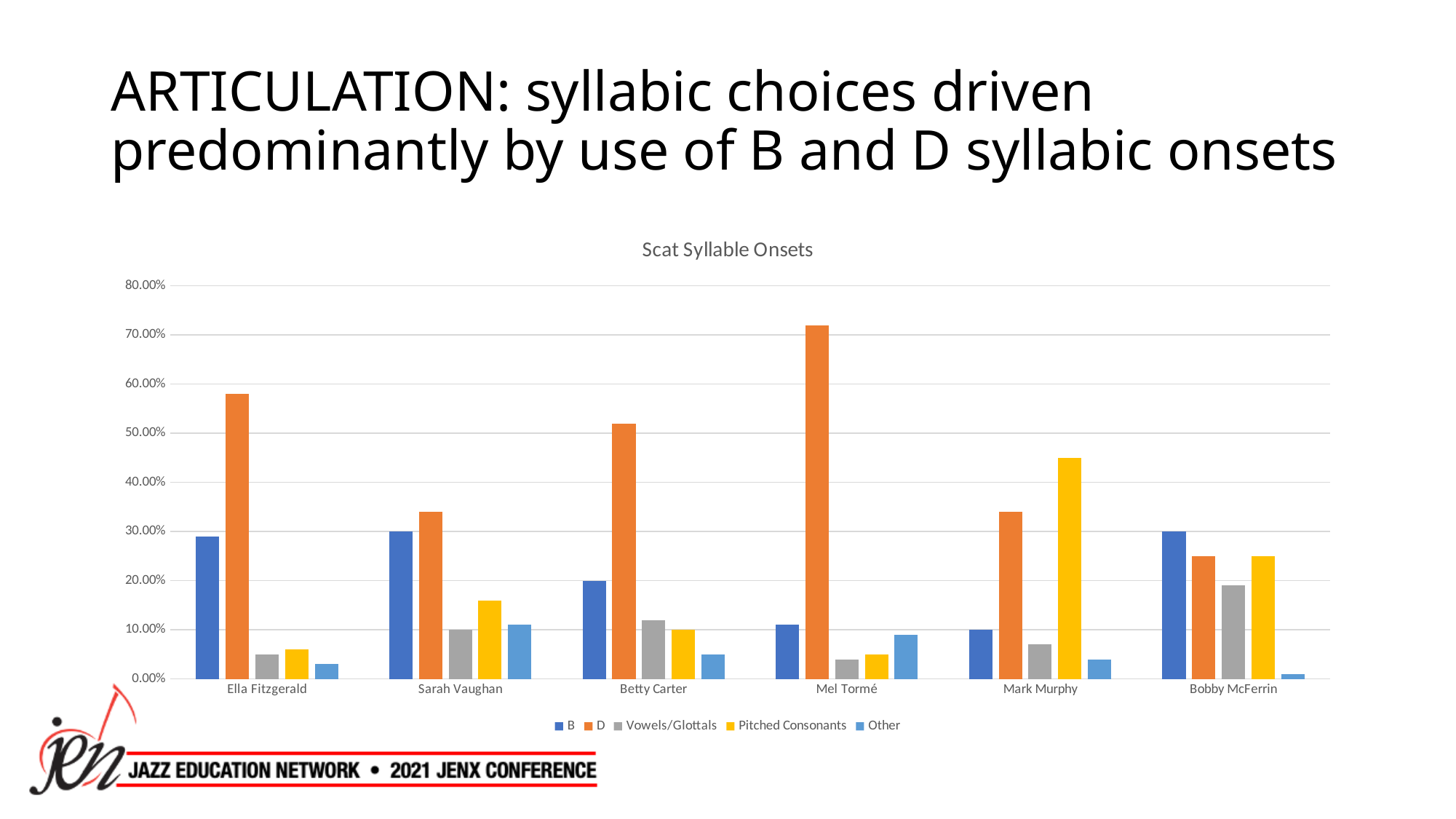
Which is larger for Bobby McFerrin, the B value or the D value? B Which singer has the lowest Other value? Bobby McFerrin What type of chart is shown on the slide? bar chart How many series does the legend list? 5 How many singers are shown on the x axis? 6 Is the D value for Ella Fitzgerald greater or less than 50.00%? greater Which is larger for Betty Carter, the B value or the D value? D What is the title of the chart? Scat Syllable Onsets Which singer has the highest D value? Mel Tormé Which singer has the highest Pitched Consonants value? Mark Murphy Is the Pitched Consonants value for Mark Murphy greater or less than 40.00%? greater Is the D value for Mel Tormé greater or less than 70.00%? greater